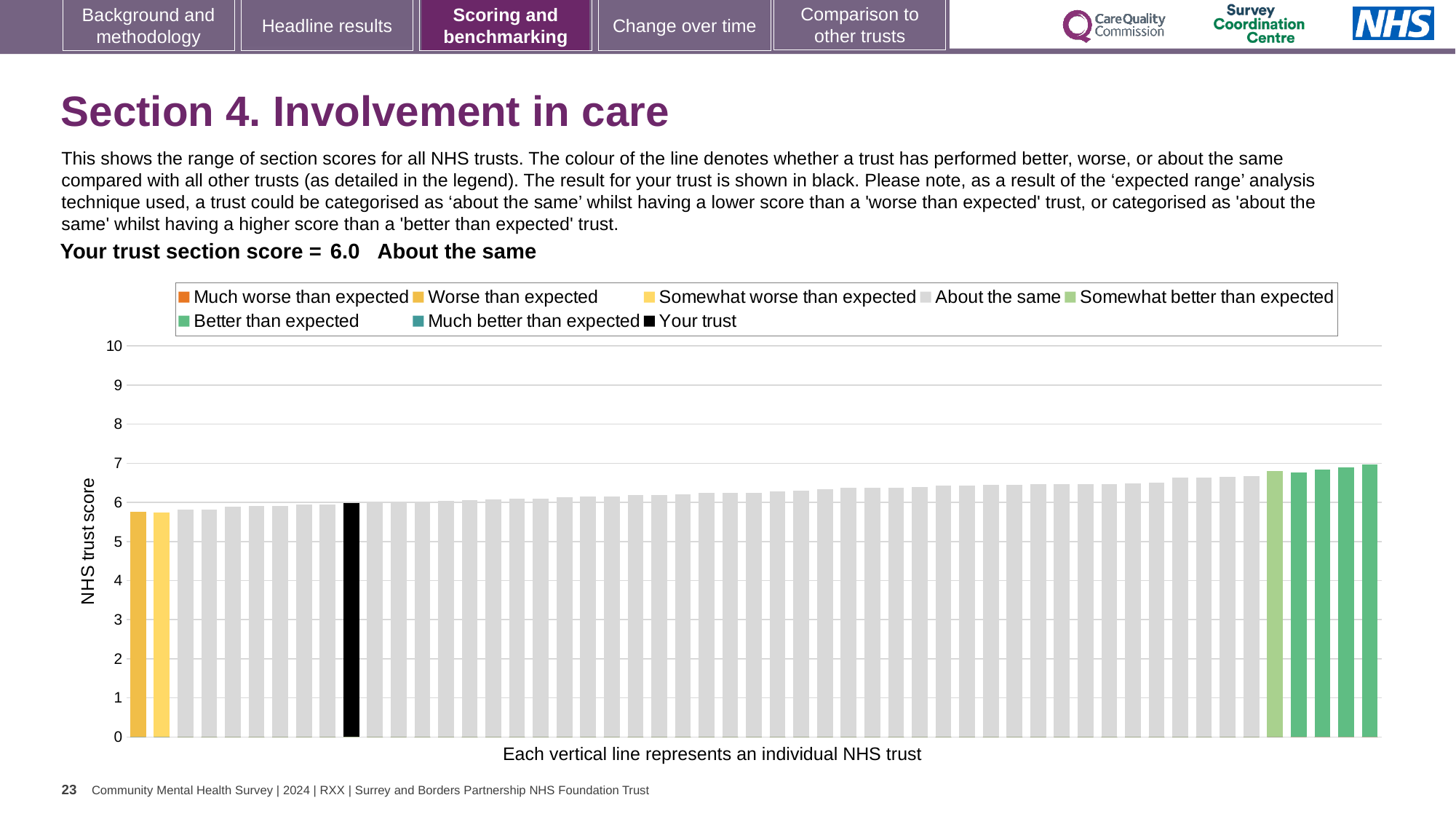
How many entries does the chart legend list? 8 Do the bar values rise or fall from left to right along the x axis? rise What is the label on the vertical axis of the chart? NHS trust score How many bars are coloured as 'Worse than expected' (yellow)? 1 Is the value of the shortest bar greater or less than 5? greater How is your trust categorised compared with other trusts? About the same Is your trust's bar higher or lower than the yellow 'Worse than expected' bars? higher Is the value for your trust (the black bar) greater or less than 5? greater What kind of chart is shown on the slide? bar chart Is the value of the tallest bar greater or less than 8? less What colour is used for your trust's bar in the chart? black What is the section score for your trust shown on the slide? 6.0